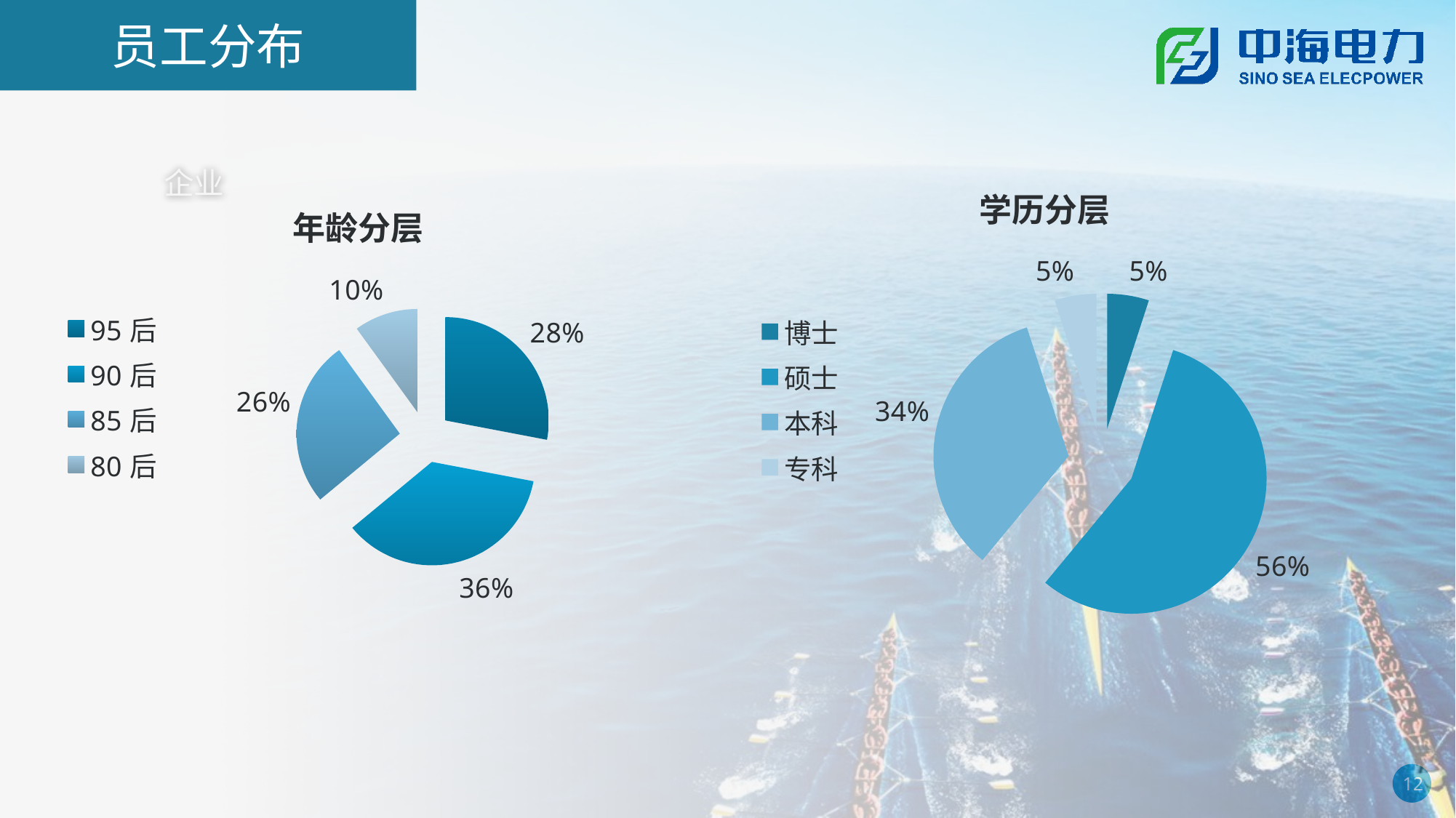
In the 年龄分层 pie chart, which age group has the largest share? 90 后 In the 学历分层 pie chart, what share is labelled for 硕士? 56% In the 年龄分层 pie chart, what is the difference between the shares of 95 后 and 85 后? 2% In the 学历分层 pie chart, which is larger, the share of 本科 or the share of 博士? 本科 In the 年龄分层 pie chart, how many categories are shown? 4 In the 年龄分层 pie chart, what share is labelled for 80 后? 10% In the 学历分层 pie chart, which education level has the largest share? 硕士 In the 年龄分层 pie chart, what share is labelled for 90 后? 36% In the 年龄分层 pie chart, which age group has the smallest share? 80 后 In the 学历分层 pie chart, what share is labelled for 本科? 34% In the 学历分层 pie chart, what is the difference between the shares of 硕士 and 本科? 22% What type of chart is the 学历分层 chart? Pie chart